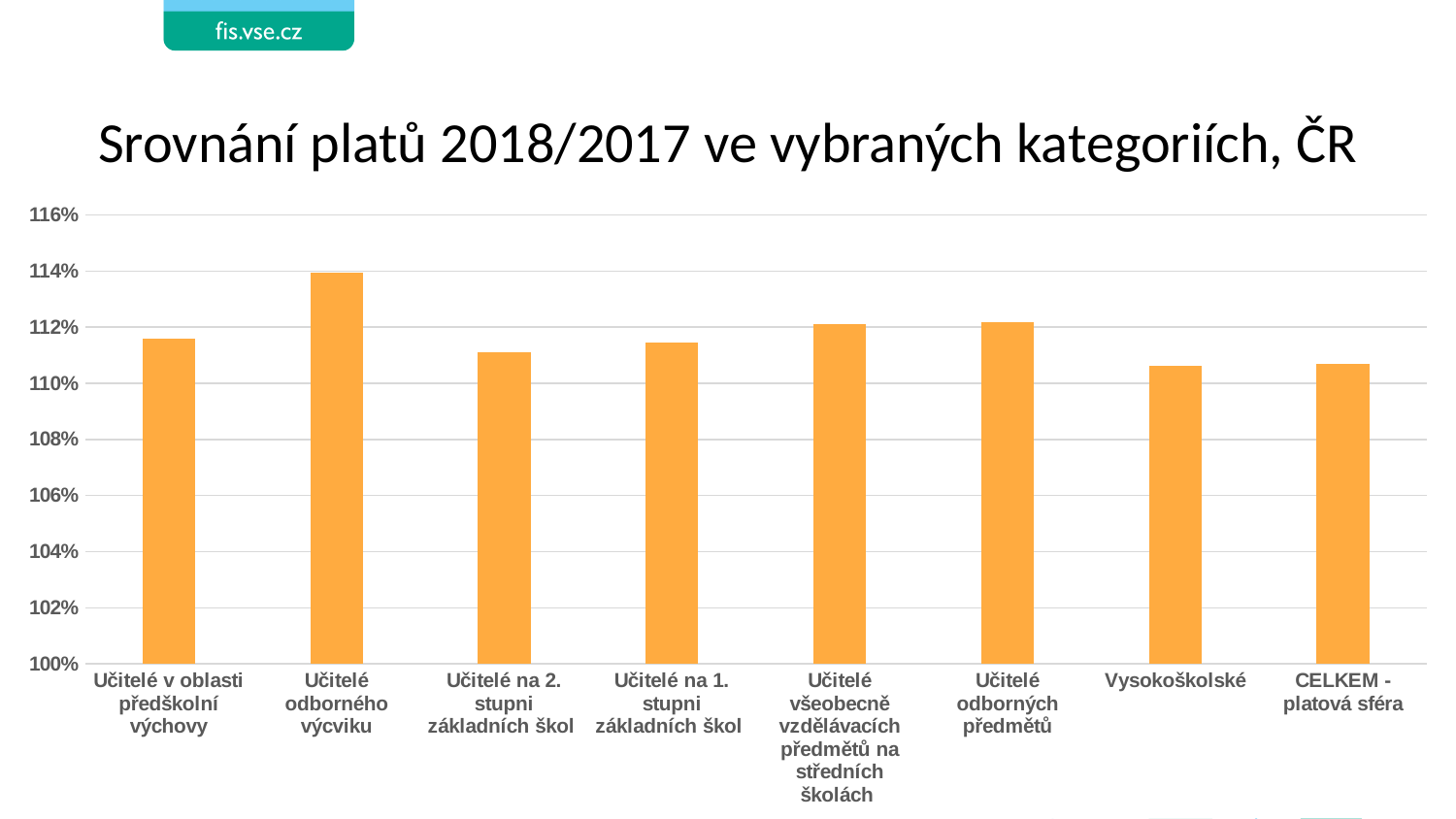
Is the value for Učitelé odborného výcviku greater or less than 112%? greater Which is larger, the value for Učitelé všeobecně vzdělávacích předmětů na středních školách or the value for Učitelé na 2. stupni základních škol? Učitelé všeobecně vzdělávacích předmětů na středních školách What is the title of the chart? Srovnání platů 2018/2017 ve vybraných kategoriích, ČR Is the value for CELKEM - platová sféra greater or less than 112%? less What kind of chart is shown on the slide? bar chart What colour are the bars in the chart? orange Is the value for Učitelé na 2. stupni základních škol greater or less than 112%? less How many categories are shown on the x axis of the chart? 8 Which is larger, the value for Učitelé odborného výcviku or the value for Učitelé v oblasti předškolní výchovy? Učitelé odborného výcviku Which category has the highest value in the chart? Učitelé odborného výcviku